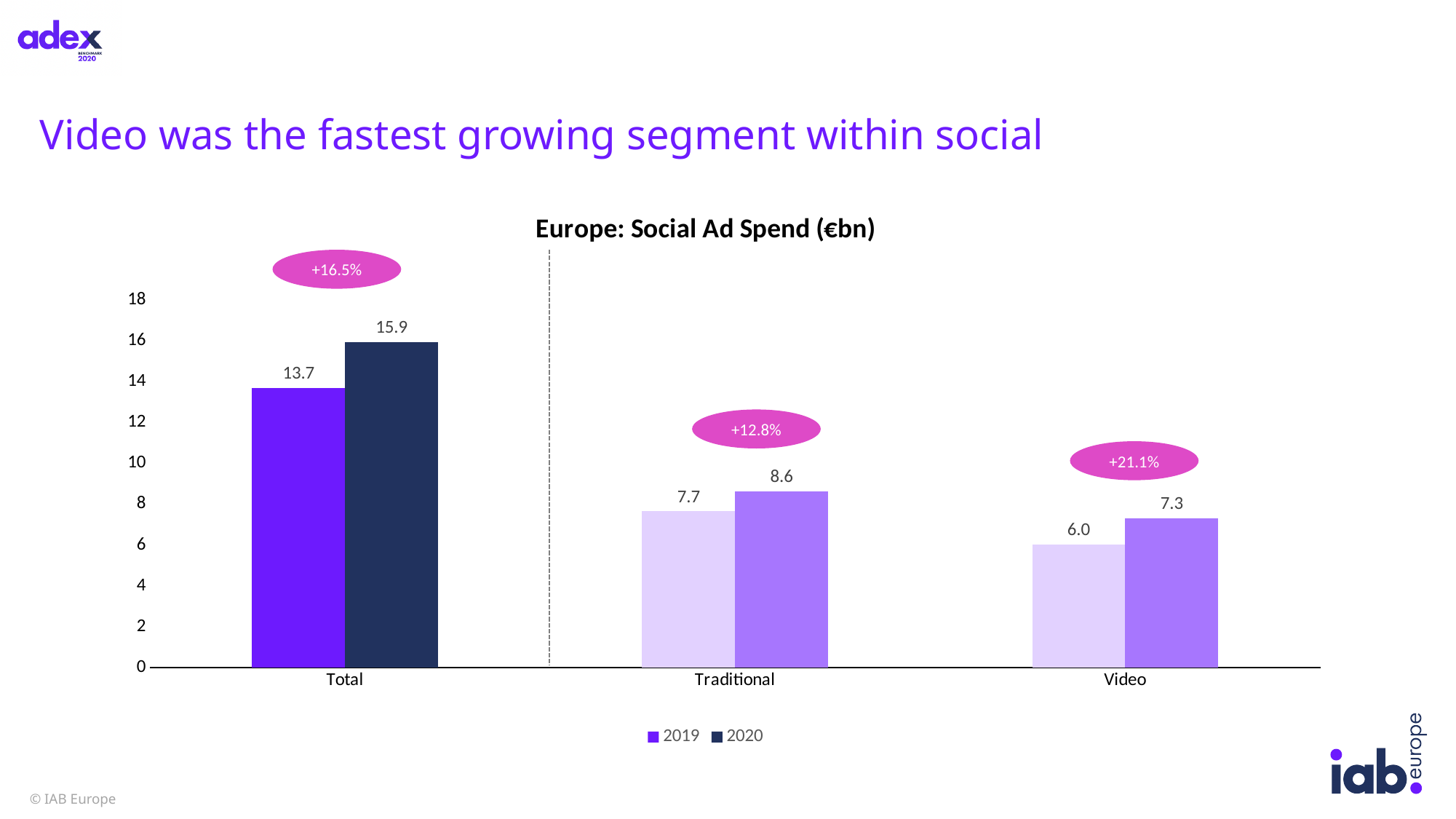
What was the social ad spend for Traditional in 2020? 8.6 Which category has the lowest 2019 value on the chart? Video What growth rate is shown for the Video segment? +21.1% Which category has the highest 2020 value on the chart? Total What was Europe's total social ad spend in 2020 according to the chart? 15.9 What is the difference between the 2020 values for Traditional and Video? 1.3 How many categories are shown on the x axis? 3 Which is larger: the 2019 value for Traditional or the 2020 value for Video? 2019 value for Traditional How many series does the legend list? 2 What type of chart is shown on the slide? Bar chart What was the social ad spend for Video in 2019? 6.0 By how much did the Total social ad spend increase from 2019 to 2020? 2.2